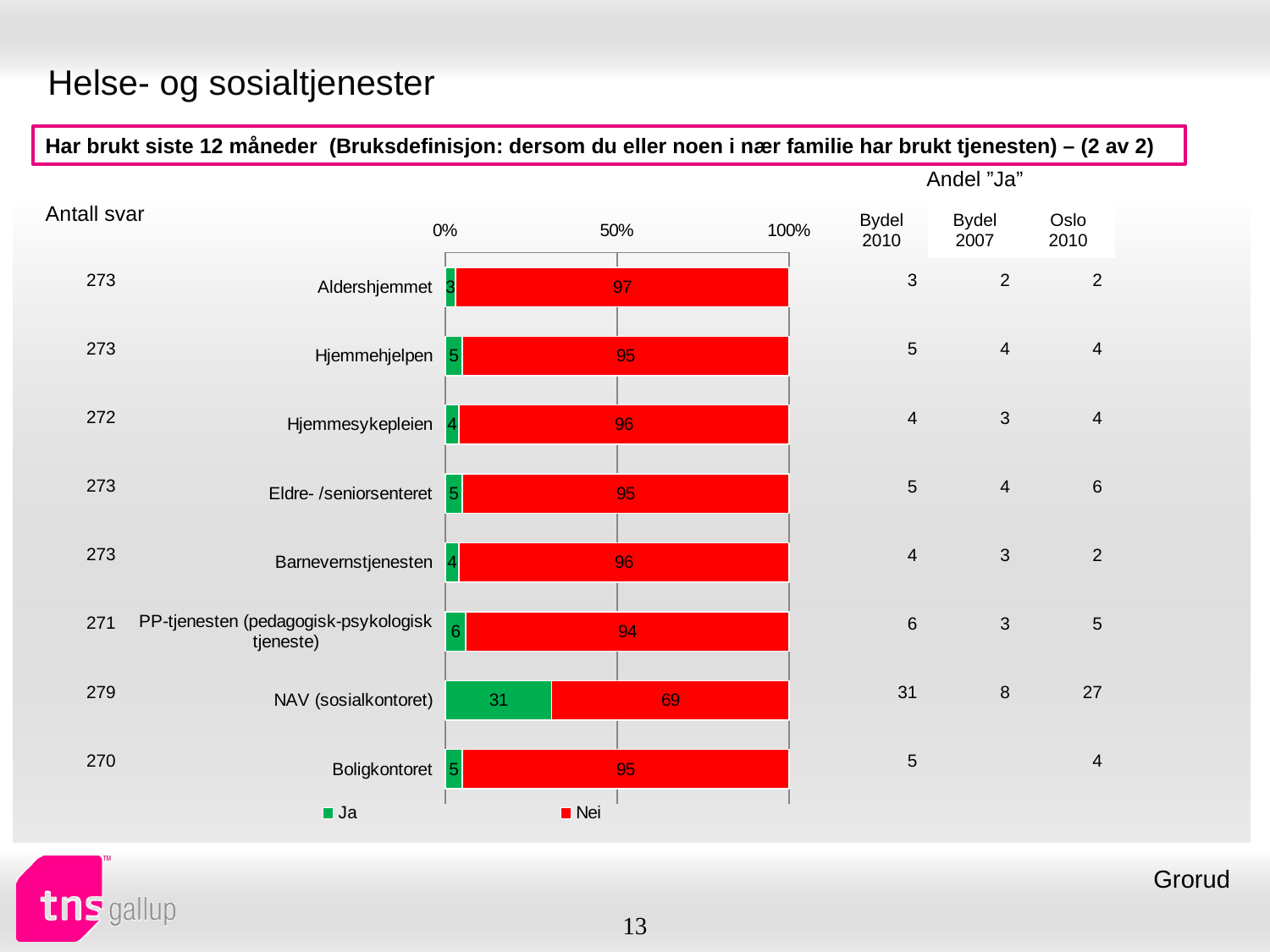
What is the difference between the 'Nei' value for NAV (sosialkontoret) and the 'Nei' value for Boligkontoret? 26 How many categories are shown in the chart? 8 What is the 'Ja' value for NAV (sosialkontoret)? 31 How many series does the legend list? 2 Which is larger: the 'Ja' value for Hjemmehjelpen or the 'Ja' value for Aldershjemmet? Hjemmehjelpen Is the 'Nei' value for NAV (sosialkontoret) greater or less than 50%? greater What is the 'Nei' value for Aldershjemmet? 97 What is the total of the stacked bar for Hjemmesykepleien? 100 Which category has the highest 'Ja' value? NAV (sosialkontoret) Which category has the lowest 'Ja' value? Aldershjemmet What is the 'Nei' value for PP-tjenesten (pedagogisk-psykologisk tjeneste)? 94 What kind of chart is shown on the slide? Stacked bar chart